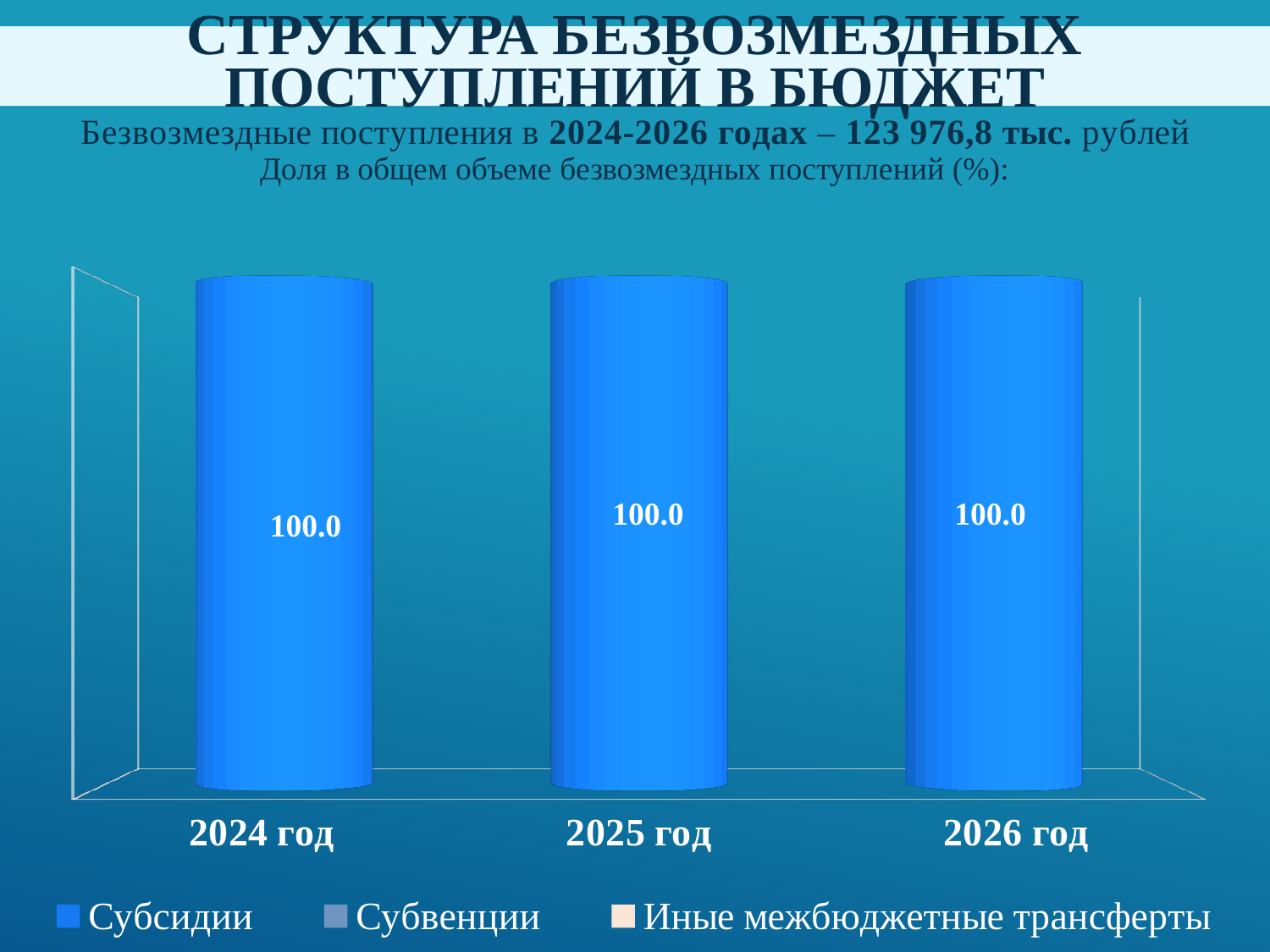
What is the value shown for Субсидии in 2024 год? 100.0 What is the value shown for Субсидии in 2026 год? 100.0 How many years (categories) are shown on the x axis of the chart? 3 What is the value shown for Субсидии in 2025 год? 100.0 Do the values for Субсидии rise, fall or stay the same from 2024 год to 2026 год? Stay the same What kind of chart is shown on the slide? Bar chart What is the difference between the Субсидии values for 2024 год and 2026 год? 0.0 Which series is shown in blue in the legend? Субсидии What is the third series listed in the legend? Иные межбюджетные трансферты Which year is the first category on the x axis? 2024 год How many series does the legend list? 3